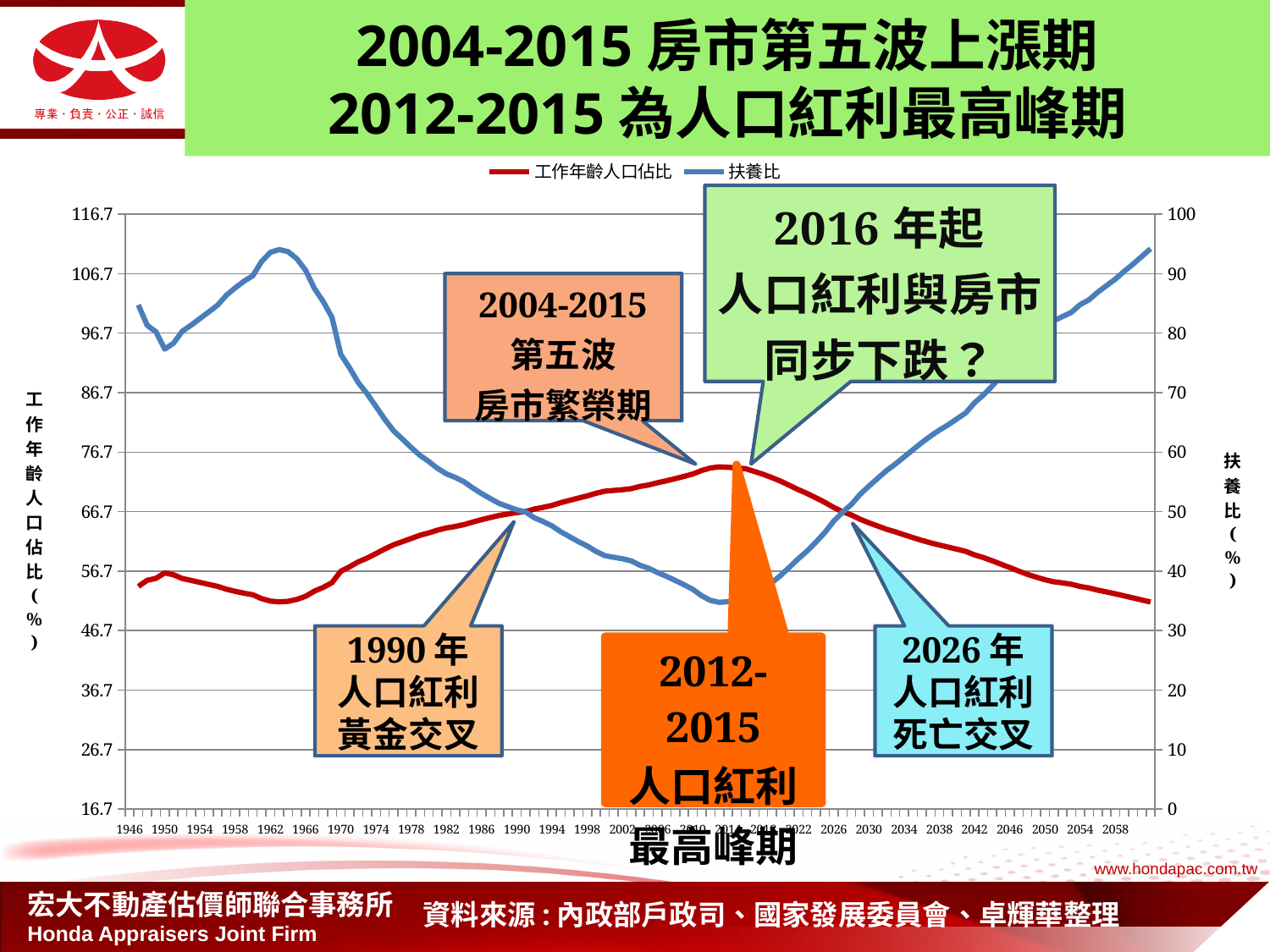
What is the highest tick value shown on the left vertical axis? 116.7 Does the 工作年齡人口佔比 line rise or fall from 2014 to 2058? fall What kind of chart is shown on the slide? line chart How many series does the legend list? 2 Which series is drawn in red according to the legend? 工作年齡人口佔比 Is the value of 工作年齡人口佔比 around 2014 greater or less than 66.7 on the left axis? greater Is the value of 扶養比 around 1962 greater or less than 80 on the right axis? greater Is the value of 工作年齡人口佔比 at 2058 greater or less than 56.7 on the left axis? less Does the 扶養比 line rise or fall from 1962 to 2014? fall Is the 工作年齡人口佔比 value higher in 2014 or in 1946? 2014